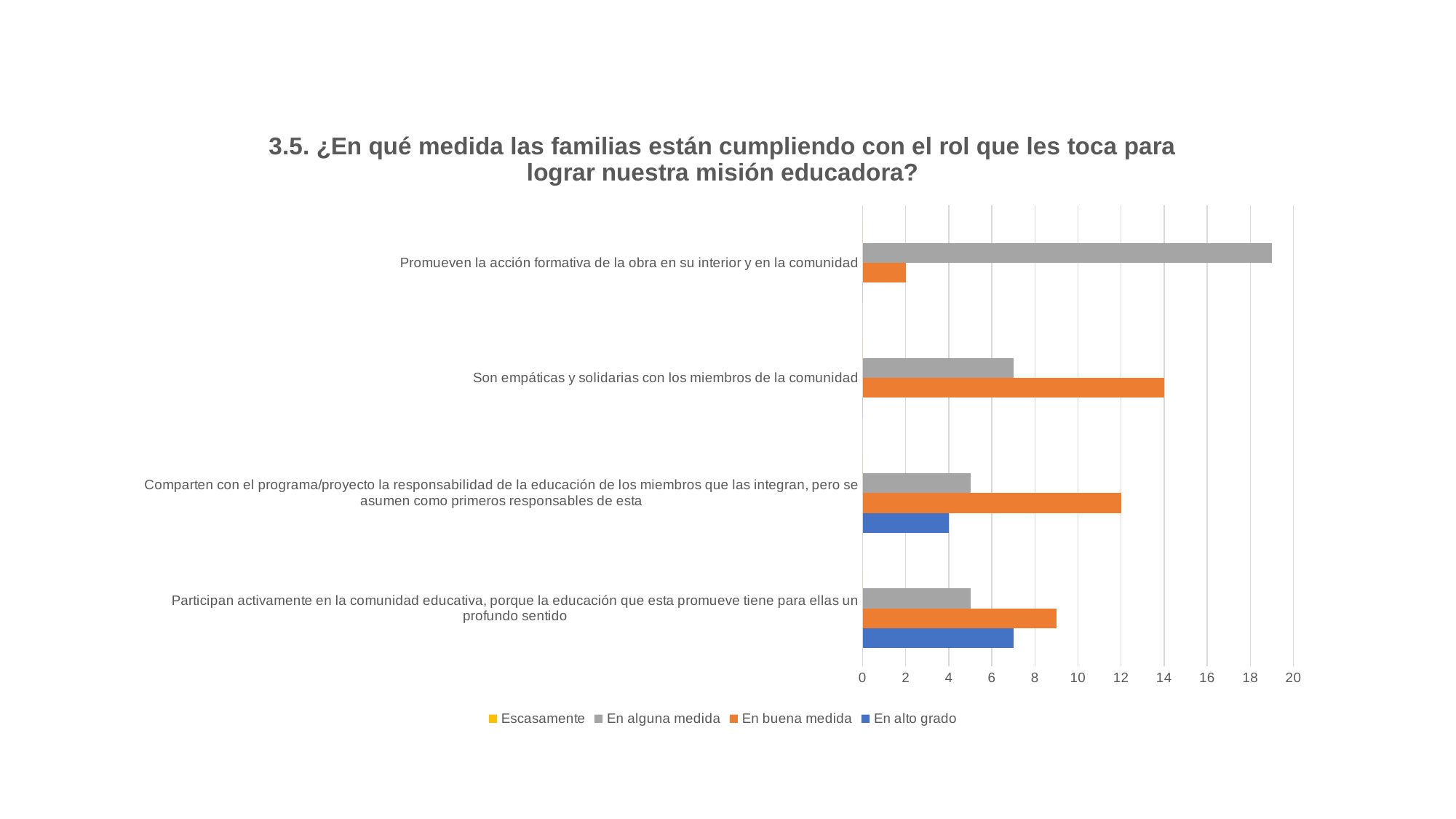
What is the value of 'En alto grado' for 'Comparten con el programa/proyecto la responsabilidad de la educación de los miembros que las integran, pero se asumen como primeros responsables de esta'? 4 What is the value of 'En buena medida' for 'Son empáticas y solidarias con los miembros de la comunidad'? 14 How many series does the legend list? 4 Is the value of 'En alguna medida' for 'Promueven la acción formativa de la obra en su interior y en la comunidad' greater or less than 18? greater How many categories (statements) are plotted on the chart? 4 Which category has the highest 'En alguna medida' value? Promueven la acción formativa de la obra en su interior y en la comunidad Which series in the legend is shown in orange? En buena medida What is the value of 'En buena medida' for 'Promueven la acción formativa de la obra en su interior y en la comunidad'? 2 What type of chart is shown on the slide? bar chart Is the value of 'En alto grado' for 'Participan activamente en la comunidad educativa, porque la educación que esta promueve tiene para ellas un profundo sentido' greater or less than 6? greater For 'Son empáticas y solidarias con los miembros de la comunidad', which is larger: 'En alguna medida' or 'En buena medida'? En buena medida What is the value of 'En buena medida' for 'Comparten con el programa/proyecto la responsabilidad de la educación de los miembros que las integran, pero se asumen como primeros responsables de esta'? 12